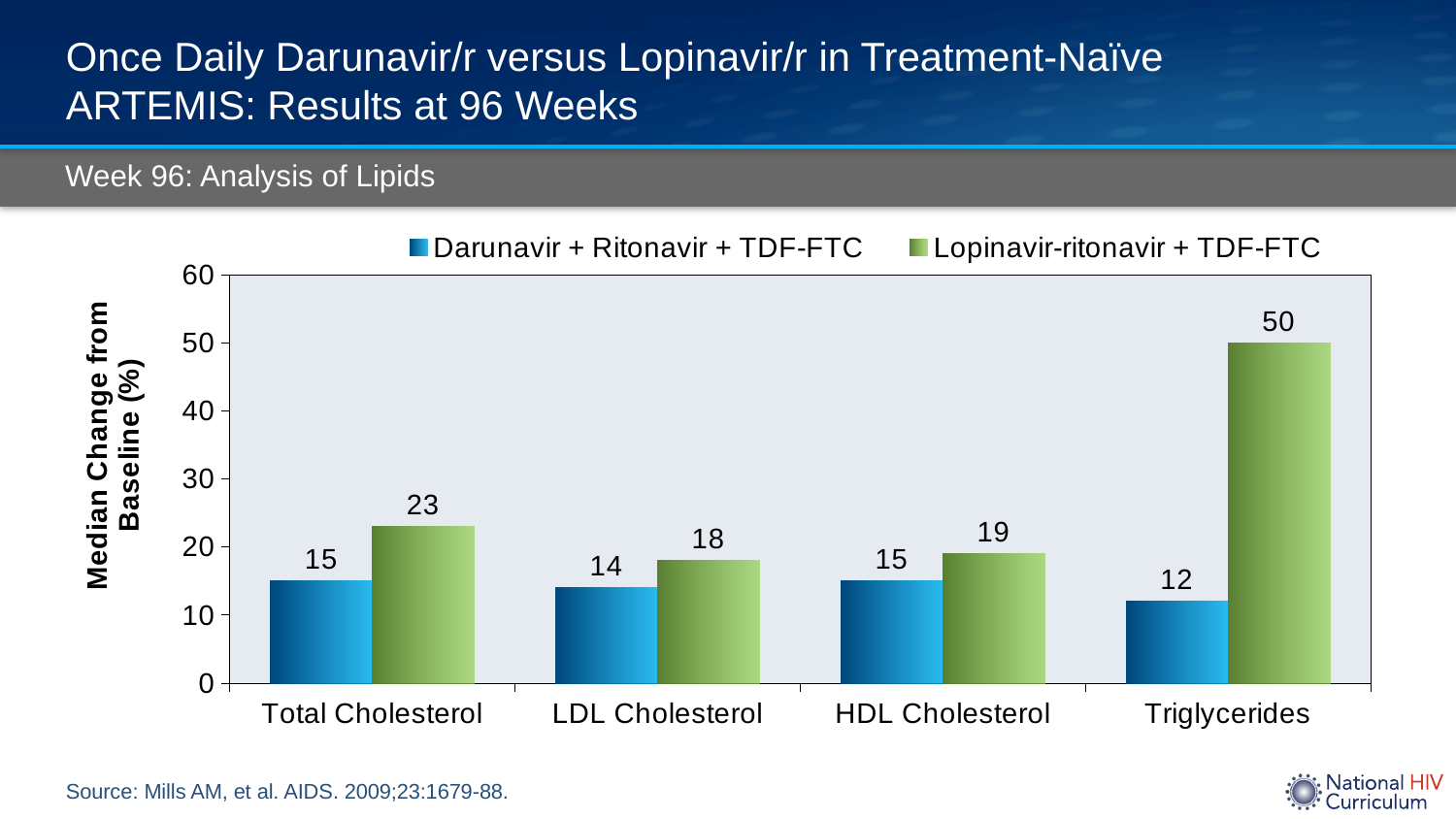
What is the median change from baseline for LDL Cholesterol in the Darunavir + Ritonavir + TDF-FTC group? 14 Which lipid category has the lowest value for the Darunavir + Ritonavir + TDF-FTC group? Triglycerides Is the value for Triglycerides in the Lopinavir-ritonavir + TDF-FTC group greater or less than 40? greater What is the difference between the two groups for Total Cholesterol? 8 Which lipid category has the highest value for the Lopinavir-ritonavir + TDF-FTC group? Triglycerides For LDL Cholesterol, which group has the larger median change from baseline? Lopinavir-ritonavir + TDF-FTC What is the median change from baseline for HDL Cholesterol in the Lopinavir-ritonavir + TDF-FTC group? 19 What is the median change from baseline for Triglycerides in the Lopinavir-ritonavir + TDF-FTC group? 50 How many lipid categories are shown on the x axis? 4 How many series does the legend list? 2 What kind of chart is shown on the slide? Bar chart What is the difference between the Lopinavir-ritonavir + TDF-FTC and Darunavir + Ritonavir + TDF-FTC values for Triglycerides? 38